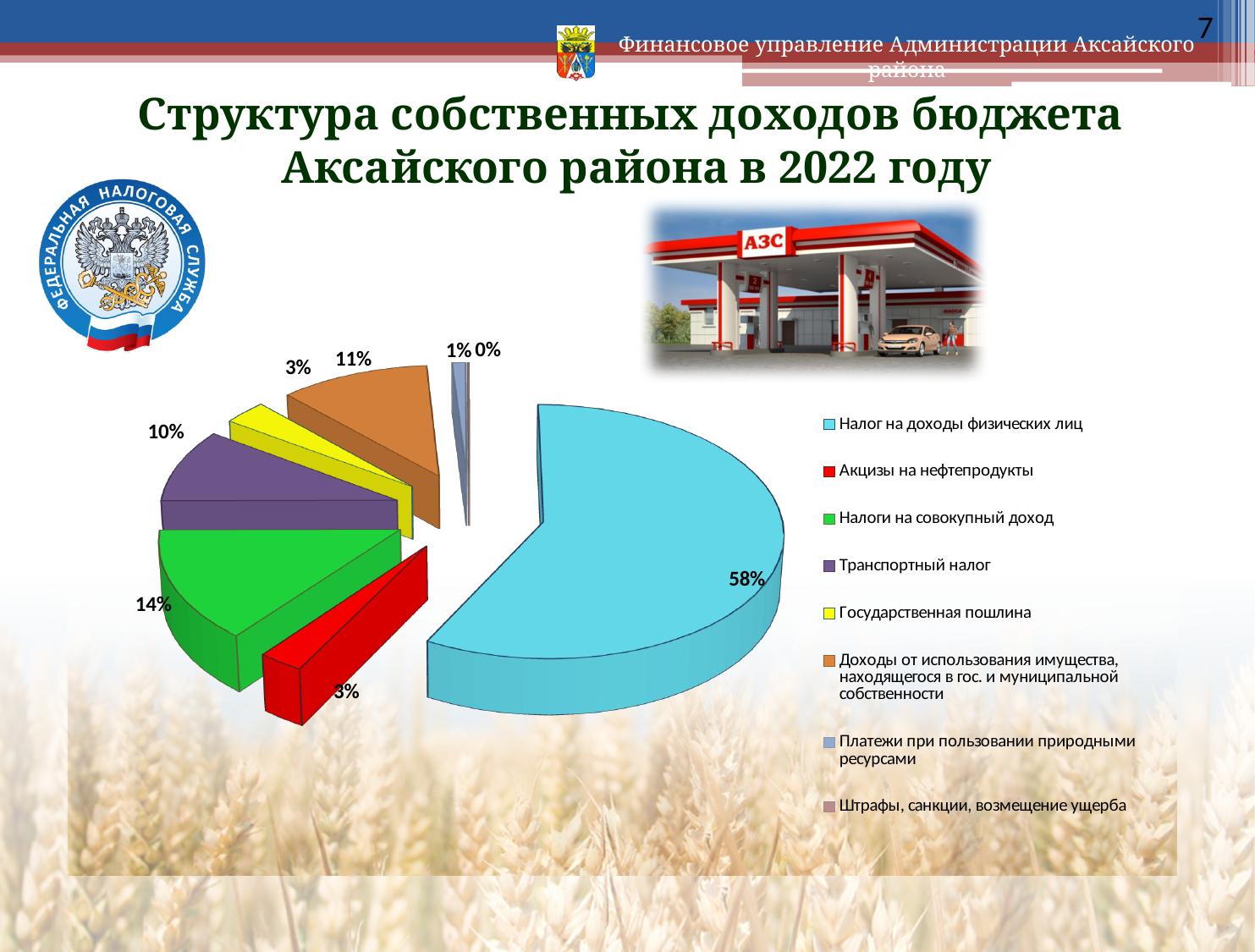
What kind of chart is shown on the slide? Pie chart What share of the pie does "Налоги на совокупный доход" have? 14% Which category has the largest share of the pie? Налог на доходы физических лиц Which is larger: the share for "Транспортный налог" or the share for "Доходы от использования имущества, находящегося в гос. и муниципальной собственности"? Доходы от использования имущества, находящегося в гос. и муниципальной собственности What is the title of the slide containing the pie chart? Структура собственных доходов бюджета Аксайского района в 2022 году What share of the pie does "Транспортный налог" have? 10% Which category has the smallest share of the pie? Штрафы, санкции, возмещение ущерба What share of the pie does "Доходы от использования имущества, находящегося в гос. и муниципальной собственности" have? 11% What share of the pie does "Платежи при пользовании природными ресурсами" have? 1% What share of the pie does "Налог на доходы физических лиц" have? 58% What is the difference in percentage points between "Налог на доходы физических лиц" and "Налоги на совокупный доход"? 44 How many categories does the legend of the pie chart list? 8